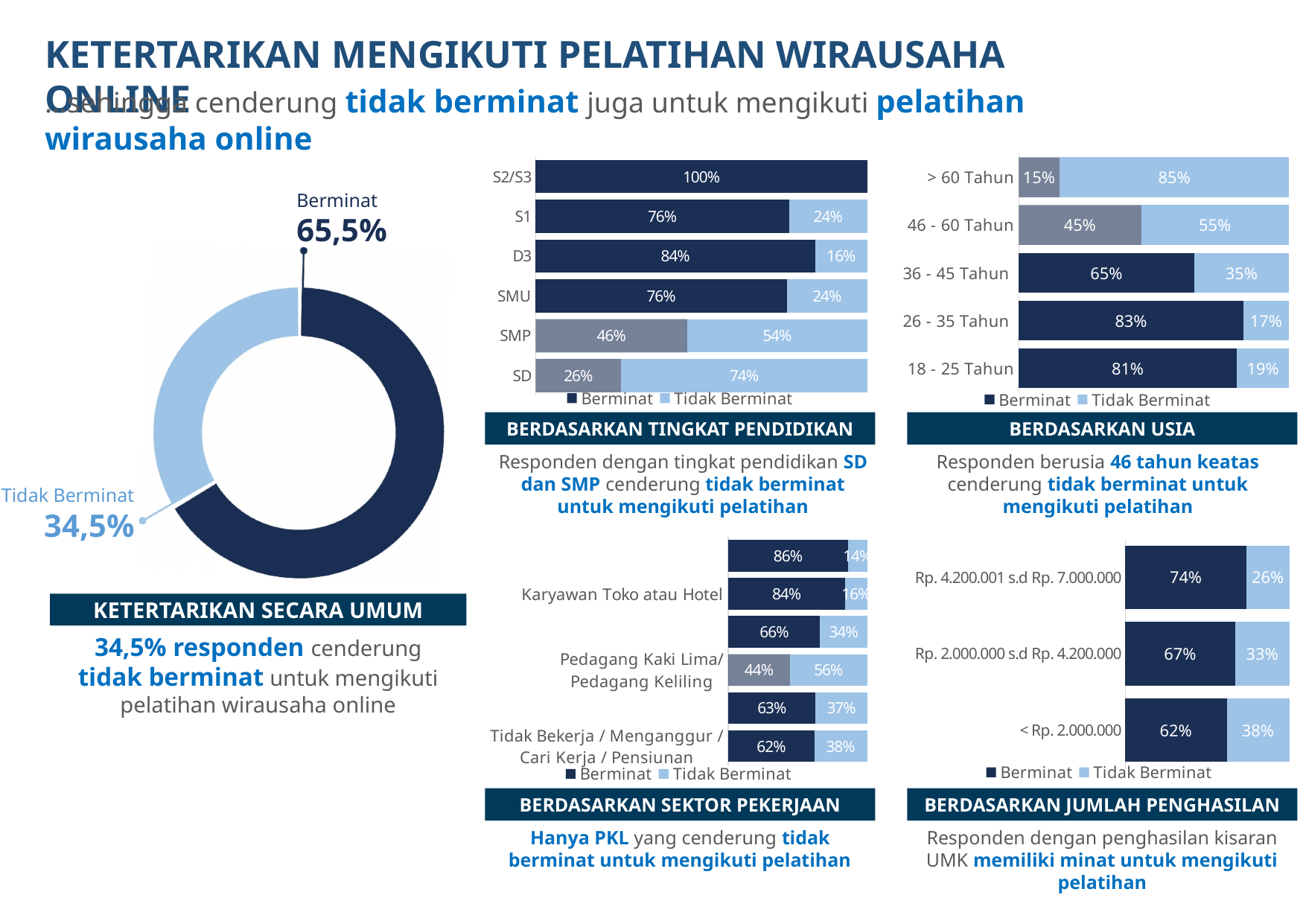
In the 'Berdasarkan Usia' chart, what is the 'Tidak Berminat' value for '> 60 Tahun'? 85% What kind of chart is the 'Ketertarikan Secara Umum' chart on the left of the slide? pie chart (donut) In the 'Berdasarkan Tingkat Pendidikan' chart, what is the 'Tidak Berminat' value for SD? 74% In the 'Berdasarkan Tingkat Pendidikan' chart, what is the 'Berminat' value for D3? 84% How many series does the legend of the 'Berdasarkan Usia' chart list? 2 In the 'Berdasarkan Tingkat Pendidikan' chart, which education level has the highest 'Berminat' value? S2/S3 In the 'Berdasarkan Usia' chart, what is the difference between the 'Berminat' values for '36 - 45 Tahun' and '46 - 60 Tahun'? 20 percentage points In the 'Berdasarkan Jumlah Penghasilan' chart, which income group has the larger 'Berminat' value: 'Rp. 4.200.001 s.d Rp. 7.000.000' or 'Rp. 2.000.000 s.d Rp. 4.200.000'? Rp. 4.200.001 s.d Rp. 7.000.000 In the 'Berdasarkan Sektor Pekerjaan' chart, what is the 'Berminat' value for 'Pedagang Kaki Lima/Pedagang Keliling'? 44% In the 'Ketertarikan Secara Umum' donut chart, what share of respondents are 'Berminat'? 65,5% In the 'Berdasarkan Jumlah Penghasilan' chart, what is the 'Berminat' value for '< Rp. 2.000.000'? 62% How many education levels are shown in the 'Berdasarkan Tingkat Pendidikan' chart? 6